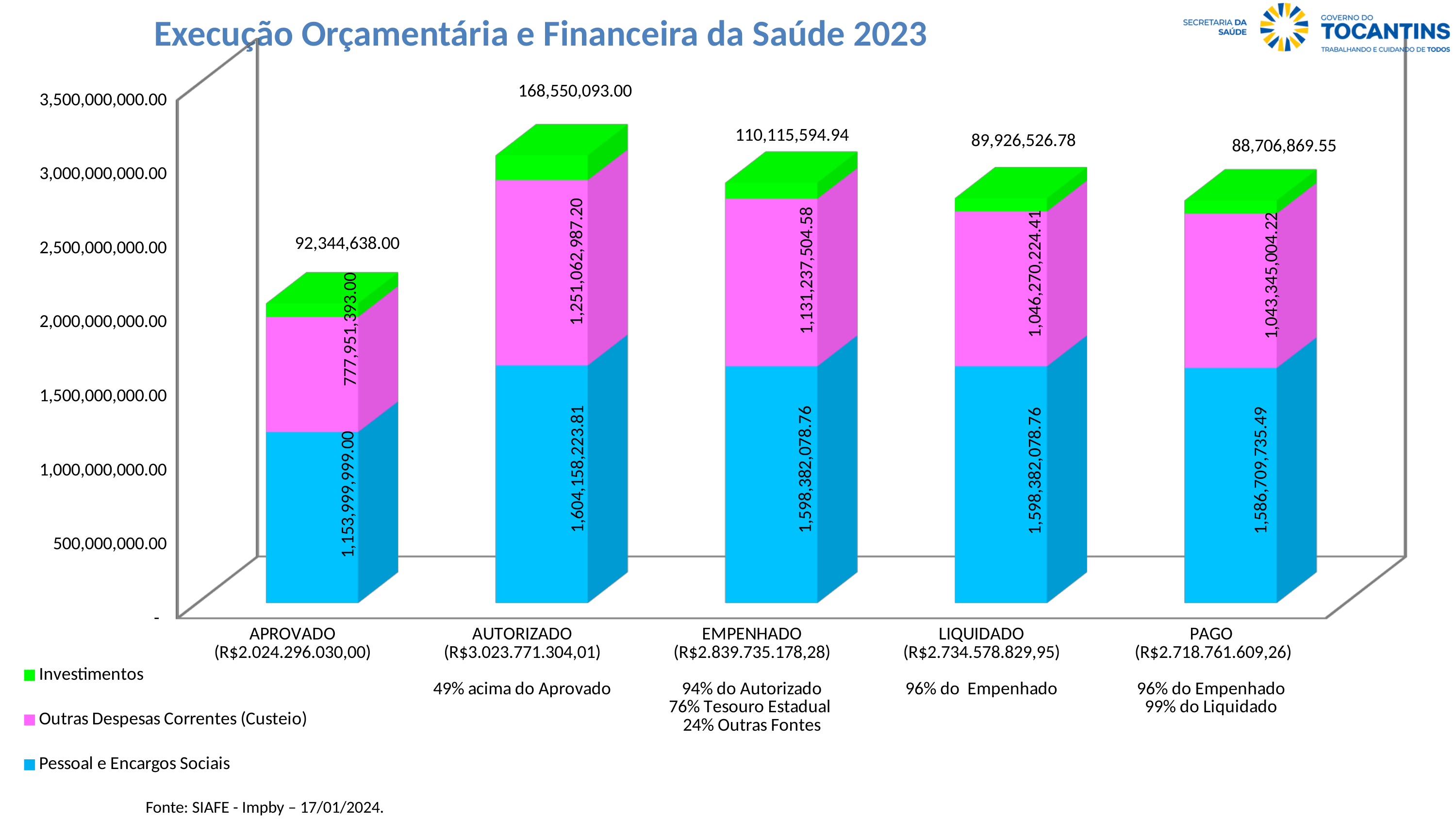
How many categories are shown on the x axis? 5 How many series does the legend list? 3 What is the value of Investimentos for AUTORIZADO? 168,550,093.00 Which category has the highest value for Investimentos? AUTORIZADO What is the value of Pessoal e Encargos Sociais for PAGO? 1,586,709,735.49 What is the total shown for the APROVADO bar? R$2.024.296.030,00 What kind of chart is shown on the slide? Stacked bar chart What is the value of Outras Despesas Correntes (Custeio) for LIQUIDADO? 1,046,270,224.41 What is the difference between the Pessoal e Encargos Sociais values for EMPENHADO and PAGO? 11,672,343.27 Which category has the lowest value for Pessoal e Encargos Sociais? APROVADO What is the difference between the Investimentos values for AUTORIZADO and APROVADO? 76,205,455.00 Which is larger, the Outras Despesas Correntes (Custeio) value for EMPENHADO or for PAGO? EMPENHADO